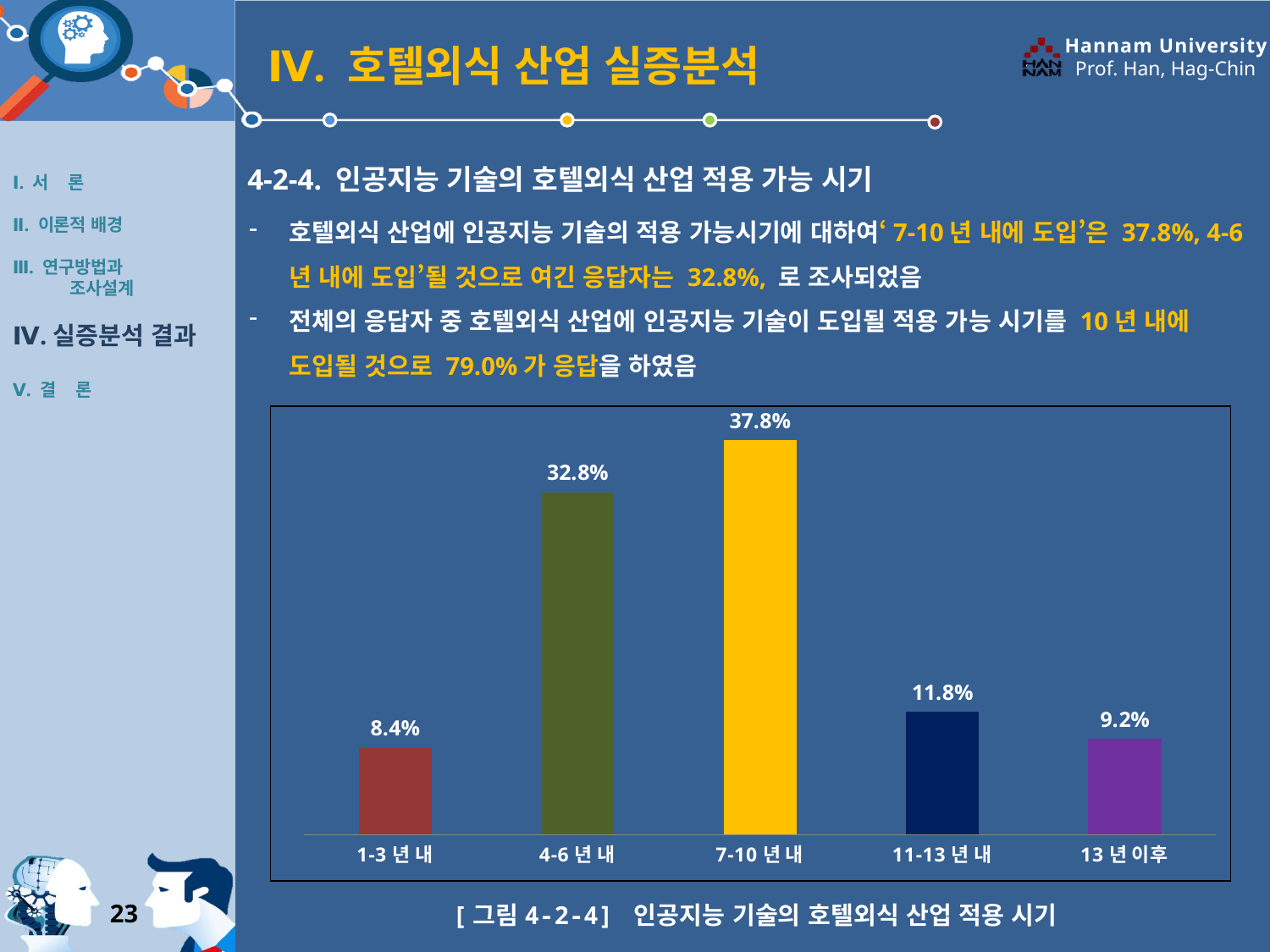
Which category has the highest value? 7-10 년 내 What is the value for the '13 년 이후' category? 9.2% How many categories are shown on the x axis? 5 What kind of chart is shown on the slide? Bar chart Which category has the lowest value? 1-3 년 내 What is the value for the '1-3 년 내' category? 8.4% Which is larger, the value for '11-13 년 내' or the value for '13 년 이후'? 11-13 년 내 What is the combined value of the '1-3 년 내' and '4-6 년 내' categories? 41.2% What colour is the bar for '7-10 년 내'? Yellow What is the value for the '11-13 년 내' category? 11.8% What is the difference between the values for '7-10 년 내' and '4-6 년 내'? 5.0% What is the value for the '7-10 년 내' category? 37.8%